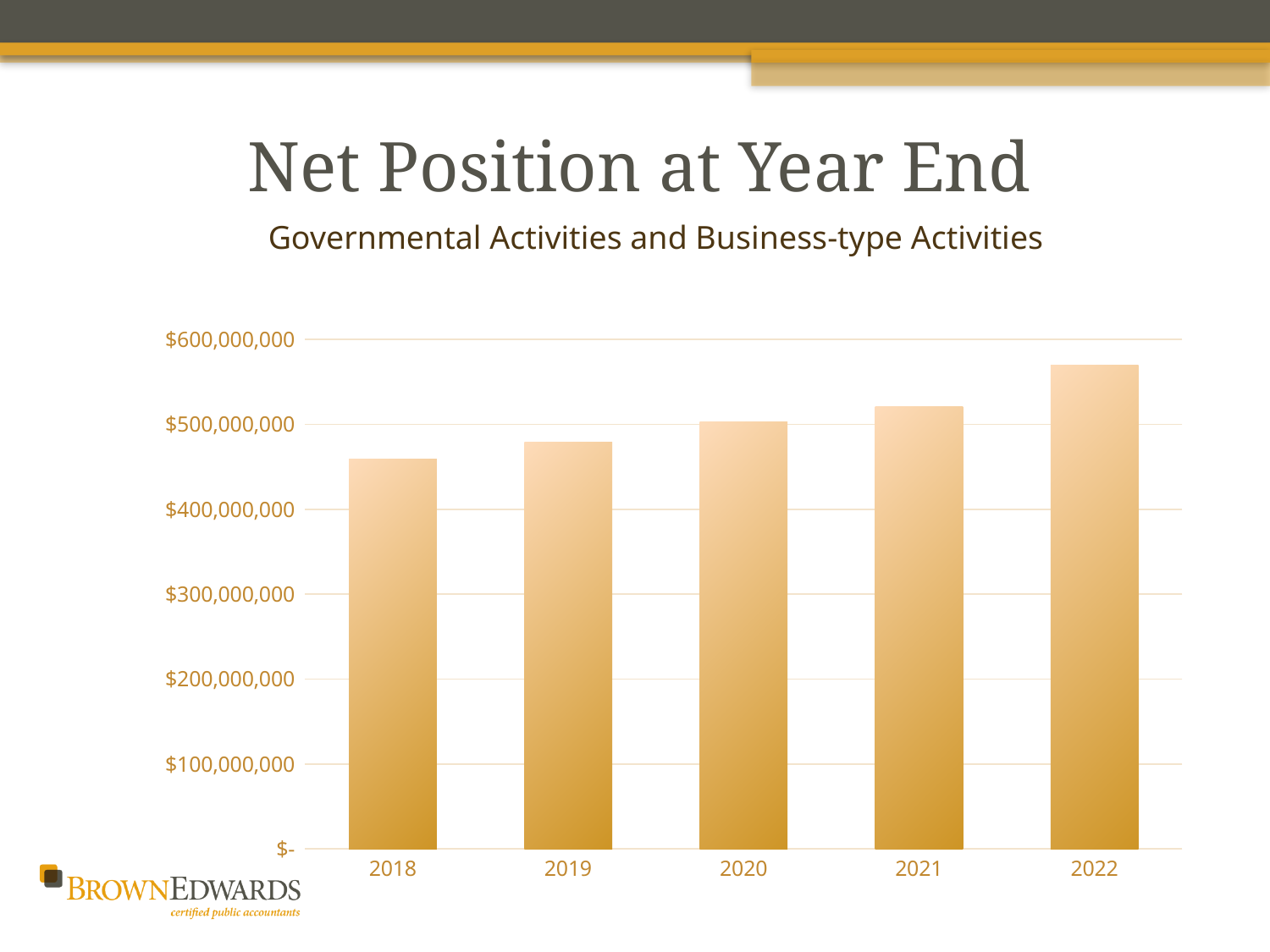
What kind of chart is shown on the slide? bar chart Is the value for 2018 greater or less than $500,000,000? less How many years are plotted on the x axis of the chart? 5 Which year has a larger net position, 2019 or 2021? 2021 Do the values rise or fall from 2018 to 2022? rise Which year has the highest net position at year end? 2022 Is the value for 2022 greater or less than $600,000,000? less Which year has a larger net position, 2018 or 2022? 2022 Is the value for 2021 greater or less than $500,000,000? greater Which year has the lowest net position at year end? 2018 What is the title of the chart on the slide? Net Position at Year End